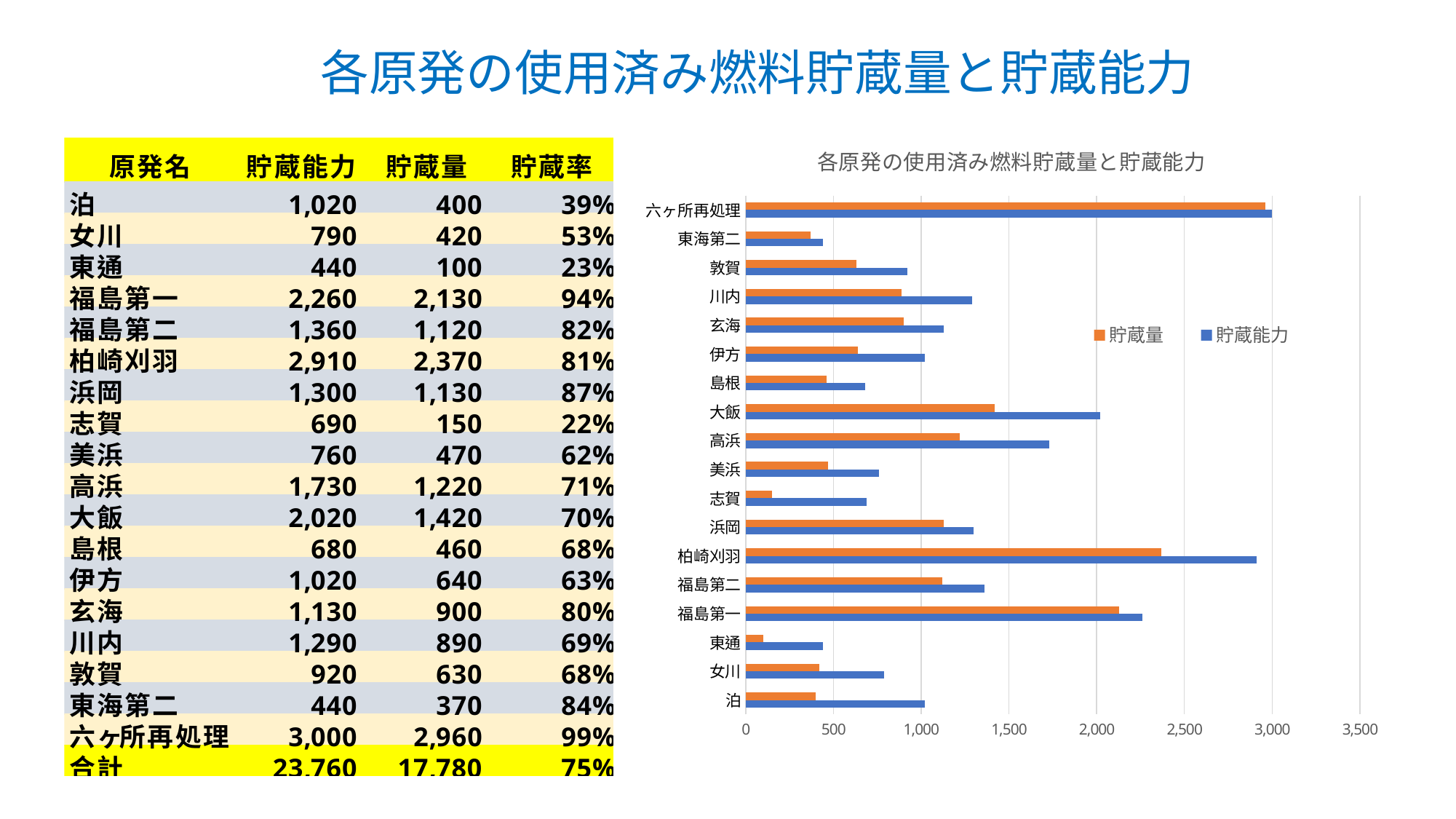
Is the 貯蔵能力 value for 福島第一 greater or less than 2,000? greater What is the 貯蔵量 value for 福島第一? 2,130 Which facility has the highest 貯蔵能力 in the chart? 六ヶ所再処理 Which colour represents the 貯蔵量 series in the chart? orange What is the 貯蔵能力 value for 柏崎刈羽? 2,910 What is the difference between the 貯蔵能力 and 貯蔵量 for 柏崎刈羽? 540 Which has the larger 貯蔵能力, 大飯 or 高浜? 大飯 Is the 貯蔵量 value for 志賀 greater or less than 500? less How many nuclear facilities (categories) are plotted in the chart? 18 Which facility has the lowest 貯蔵量 in the chart? 東通 What kind of chart is shown on the slide? bar chart How many series does the chart legend list? 2